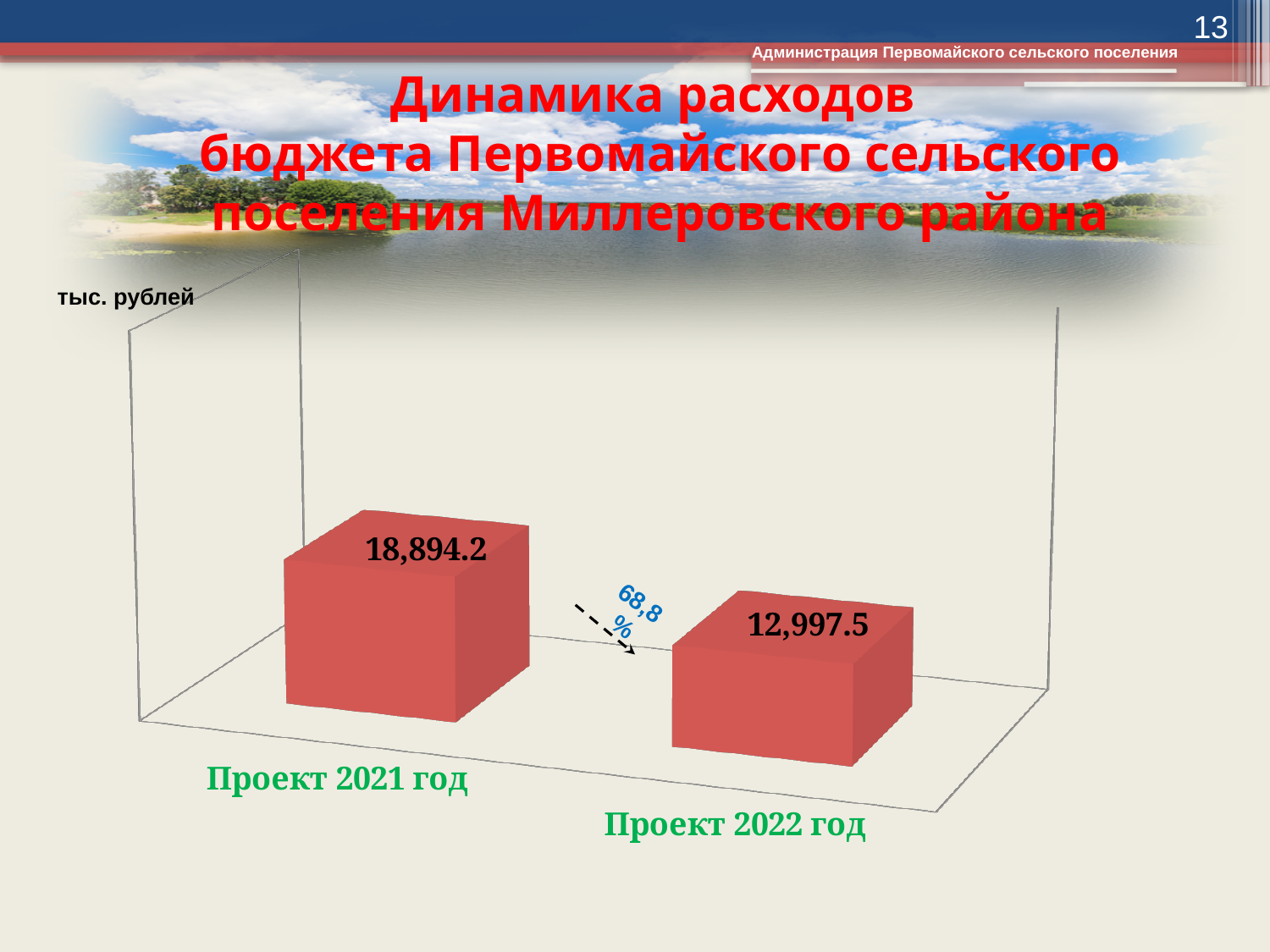
What is the difference between the values for Проект 2021 год and Проект 2022 год? 5,896.7 Which category has the highest value? Проект 2021 год What kind of chart is shown on the slide? Bar chart What unit of measurement is indicated on the chart? тыс. рублей Do the values rise or fall from Проект 2021 год to Проект 2022 год? Fall Which category has the lowest value? Проект 2022 год What is the value for Проект 2022 год? 12,997.5 Which is larger, the value for Проект 2021 год or Проект 2022 год? Проект 2021 год How many categories are shown in the chart? 2 What percentage is shown next to the arrow between the two bars? 68,8 % What is the value for Проект 2021 год? 18,894.2